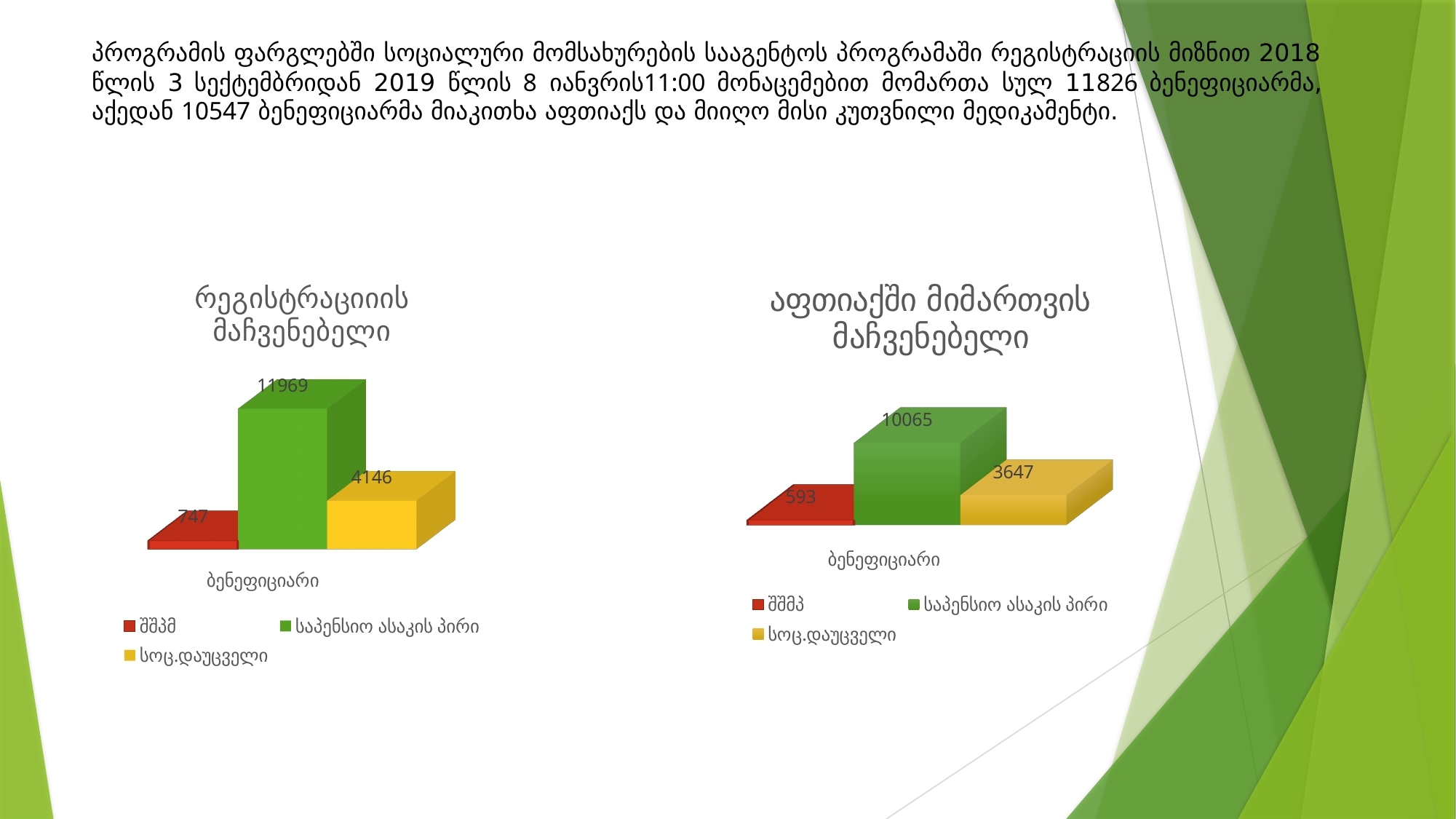
In the left chart (რეგისტრაციის მაჩვენებელი), what is the value for შშმ? 747 In the right chart (აფთიაქში მიმართვის მაჩვენებელი), what is the difference between the values for სოც.დაუცველი and შშმ? 3054 In the left chart (რეგისტრაციის მაჩვენებელი), what is the value for საპენსიო ასაკის პირი? 11969 What type of chart is the left chart (რეგისტრაციის მაჩვენებელი)? Bar chart In the left chart (რეგისტრაციის მაჩვენებელი), which series has the highest value? საპენსიო ასაკის პირი Which is larger: the value for სოც.დაუცველი in the left chart or the value for სოც.დაუცველი in the right chart? The left chart (4146) In the left chart, what colour is the bar for საპენსიო ასაკის პირი? Green In the left chart (რეგისტრაციის მაჩვენებელი), what is the difference between the values for საპენსიო ასაკის პირი and სოც.დაუცველი? 7823 How many series does the legend of the right chart (აფთიაქში მიმართვის მაჩვენებელი) list? 3 In the right chart (აფთიაქში მიმართვის მაჩვენებელი), what is the value for შშმ? 593 In the right chart (აფთიაქში მიმართვის მაჩვენებელი), what is the value for სოც.დაუცველი? 3647 In the right chart (აფთიაქში მიმართვის მაჩვენებელი), which series has the lowest value? შშმპ